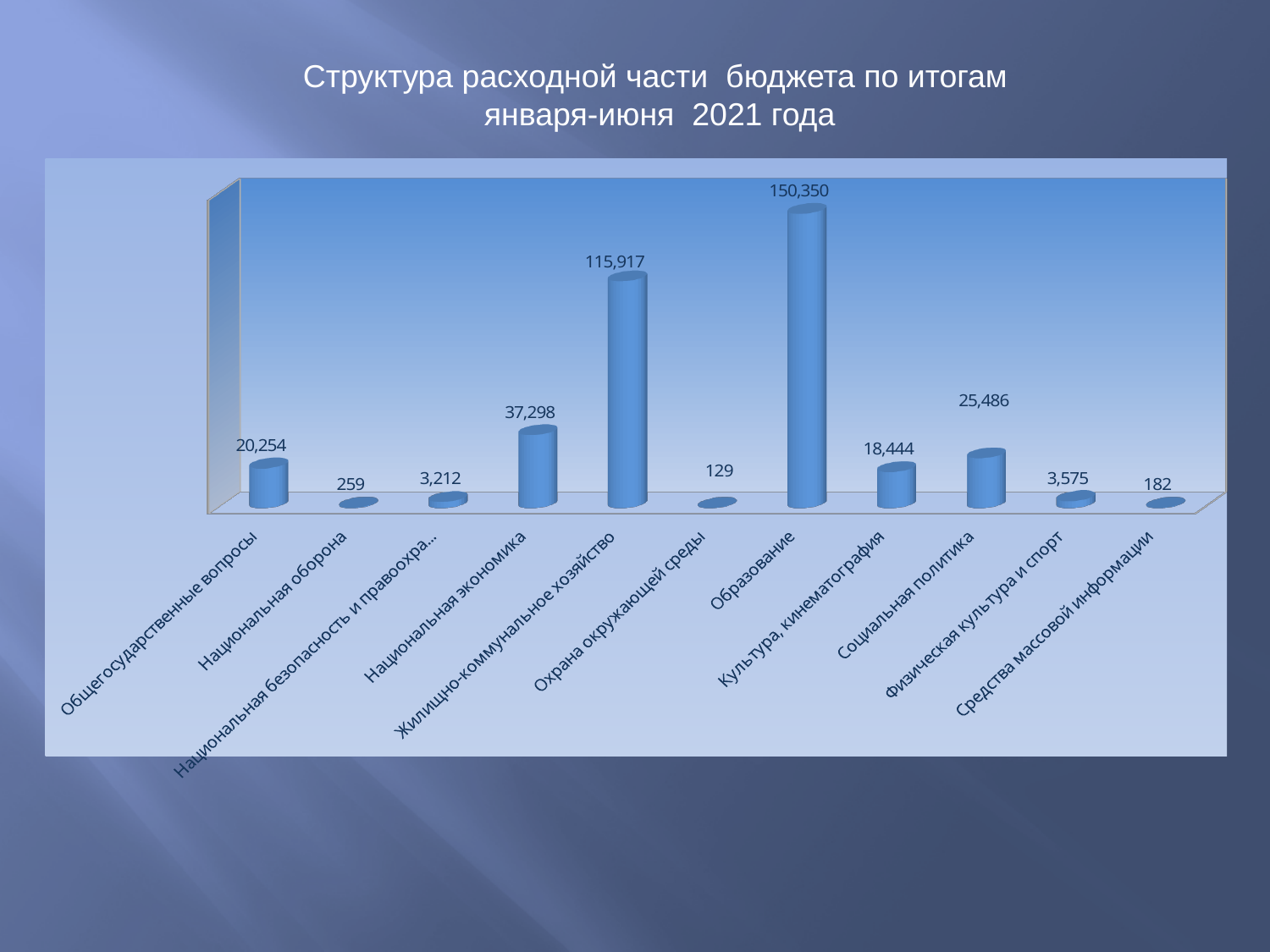
What is the value for Охрана окружающей среды? 129 What kind of chart is shown on the slide? Bar chart Which is larger, the value for Общегосударственные вопросы or the value for Культура, кинематография? Общегосударственные вопросы What is the value for Образование? 150,350 What is the value for Национальная экономика? 37,298 Which category has the lowest value? Охрана окружающей среды What is the value for Жилищно-коммунальное хозяйство? 115,917 How many categories are shown in the chart? 11 What is the value for Социальная политика? 25,486 Which category has the highest value? Образование What is the title of the slide? Структура расходной части бюджета по итогам января-июня 2021 года What is the difference between the values for Образование and Жилищно-коммунальное хозяйство? 34,433